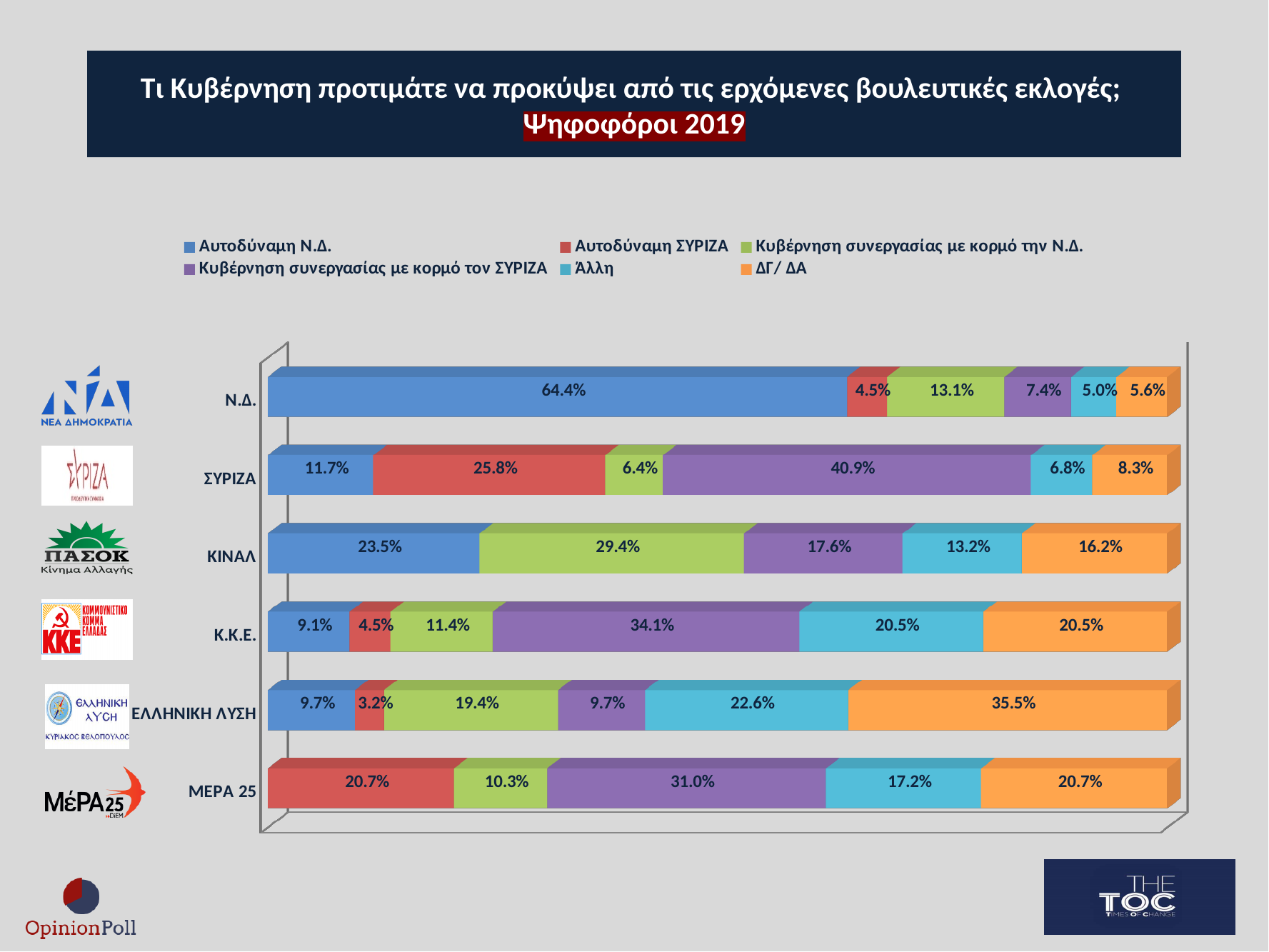
How many series does the legend list? 6 What is the value for Κυβέρνηση συνεργασίας με κορμό την Ν.Δ. among ΚΙΝΑΛ voters? 29.4% Which voter group has the lowest value for Αυτοδύναμη Ν.Δ. among those with a labelled value? Κ.Κ.Ε. What is the value for Αυτοδύναμη Ν.Δ. among Ν.Δ. voters? 64.4% What is the ΔΓ/ ΔΑ value for ΕΛΛΗΝΙΚΗ ΛΥΣΗ voters? 35.5% Which series is shown in orange in the legend? ΔΓ/ ΔΑ What is the difference between the Αυτοδύναμη ΣΥΡΙΖΑ value for ΣΥΡΙΖΑ voters and for ΜΕΡΑ 25 voters? 5.1% What kind of chart is shown on the slide? Stacked bar chart How many voter groups (categories) are shown on the chart? 6 Which is larger: the Άλλη value for Κ.Κ.Ε. voters or for ΚΙΝΑΛ voters? Κ.Κ.Ε. What is the value for Κυβέρνηση συνεργασίας με κορμό τον ΣΥΡΙΖΑ among ΣΥΡΙΖΑ voters? 40.9% Which voter group has the highest value for Αυτοδύναμη ΣΥΡΙΖΑ? ΣΥΡΙΖΑ